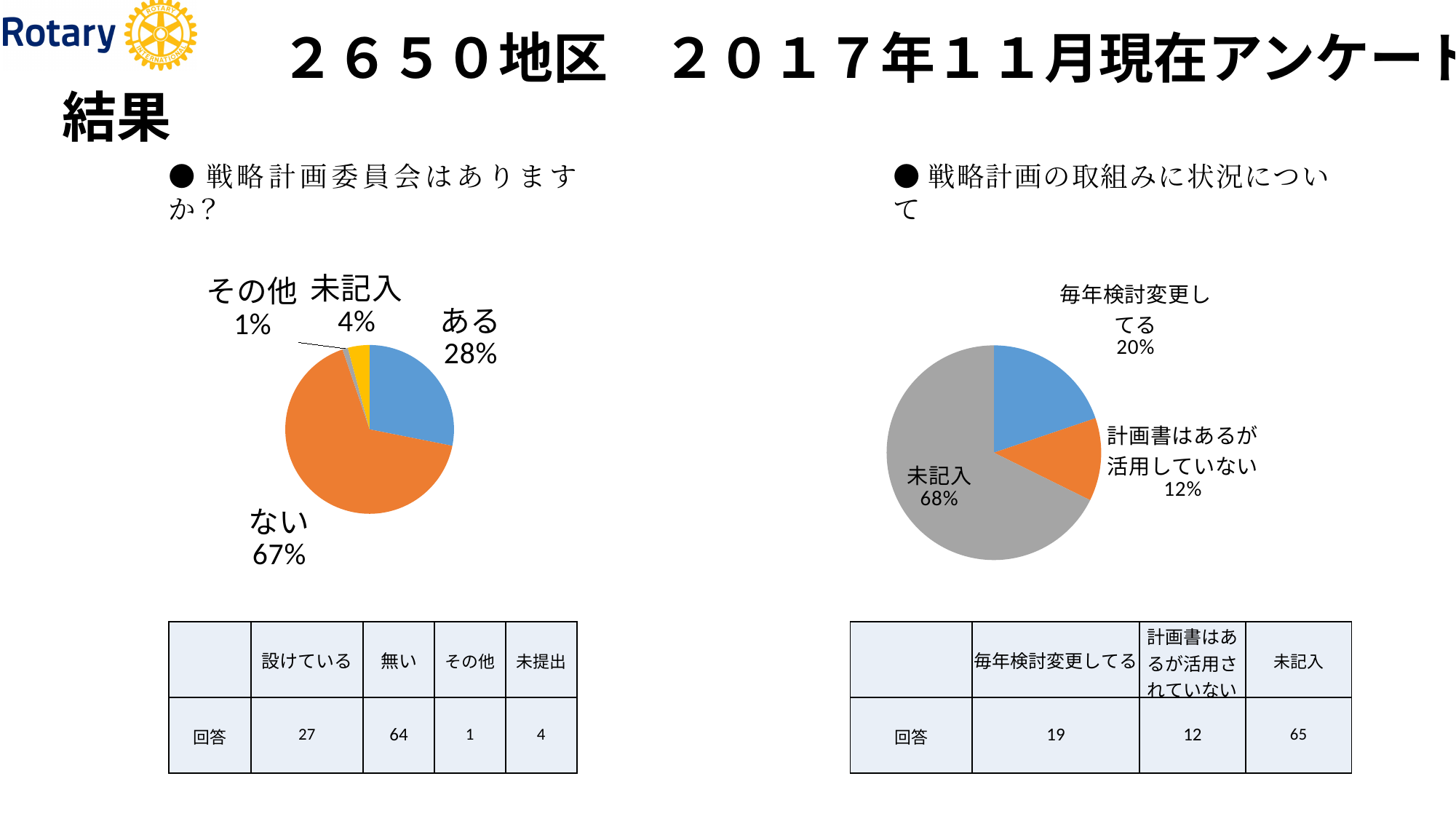
In the right pie chart, which category has the largest slice? 未記入 In the left pie chart, what share is labelled for ない? 67% In the left pie chart, what share is labelled for ある? 28% In the right pie chart, how many slices are there? 3 In the right pie chart, what share is labelled for 未記入? 68% What type of chart is shown on the left side of the slide? Pie chart In the left pie chart, which category has the smallest slice? その他 In the left pie chart, how many slices are there? 4 In the right pie chart, what share is labelled for 計画書はあるが活用していない? 12% In the left pie chart, what is the difference in percentage points between ない and ある? 39 In the right pie chart, which is larger: 毎年検討変更してる or 計画書はあるが活用していない? 毎年検討変更してる In the left pie chart, which category has the largest slice? ない